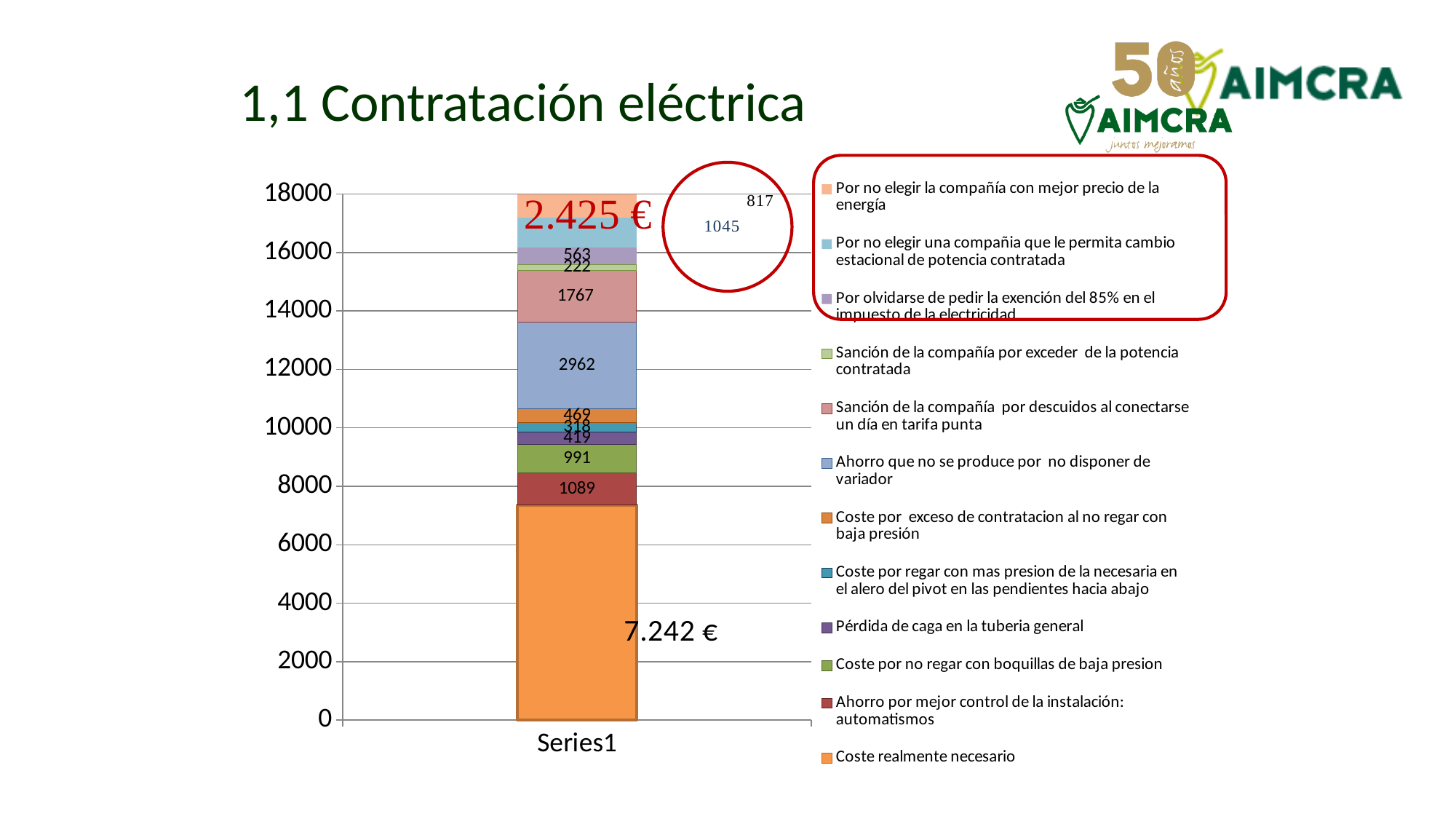
What is the value of the segment 'Ahorro por mejor control de la instalación: automatismos'? 1089 What is the value of the segment 'Por no elegir la compañía con mejor precio de la energía'? 817 What is the value of the segment 'Sanción de la compañía por descuidos al conectarse un día en tarifa punta'? 1767 How many series does the legend list? 12 Which is larger: the 'Coste por no regar con boquillas de baja presion' segment or the 'Coste por exceso de contratacion al no regar con baja presión' segment? Coste por no regar con boquillas de baja presion What is the value of the segment 'Ahorro que no se produce por no disponer de variador'? 2962 What kind of chart is shown on the slide? stacked bar chart Is the total height of the stacked bar greater or less than 16000? greater How many categories are plotted on the x axis? 1 Which labelled segment above 'Coste realmente necesario' has the largest value? Ahorro que no se produce por no disponer de variador Which labelled segment has the smallest value? Sanción de la compañía por exceder de la potencia contratada What is the difference between the 'Ahorro que no se produce por no disponer de variador' segment (2962) and the 'Sanción de la compañía por descuidos al conectarse un día en tarifa punta' segment (1767)? 1195